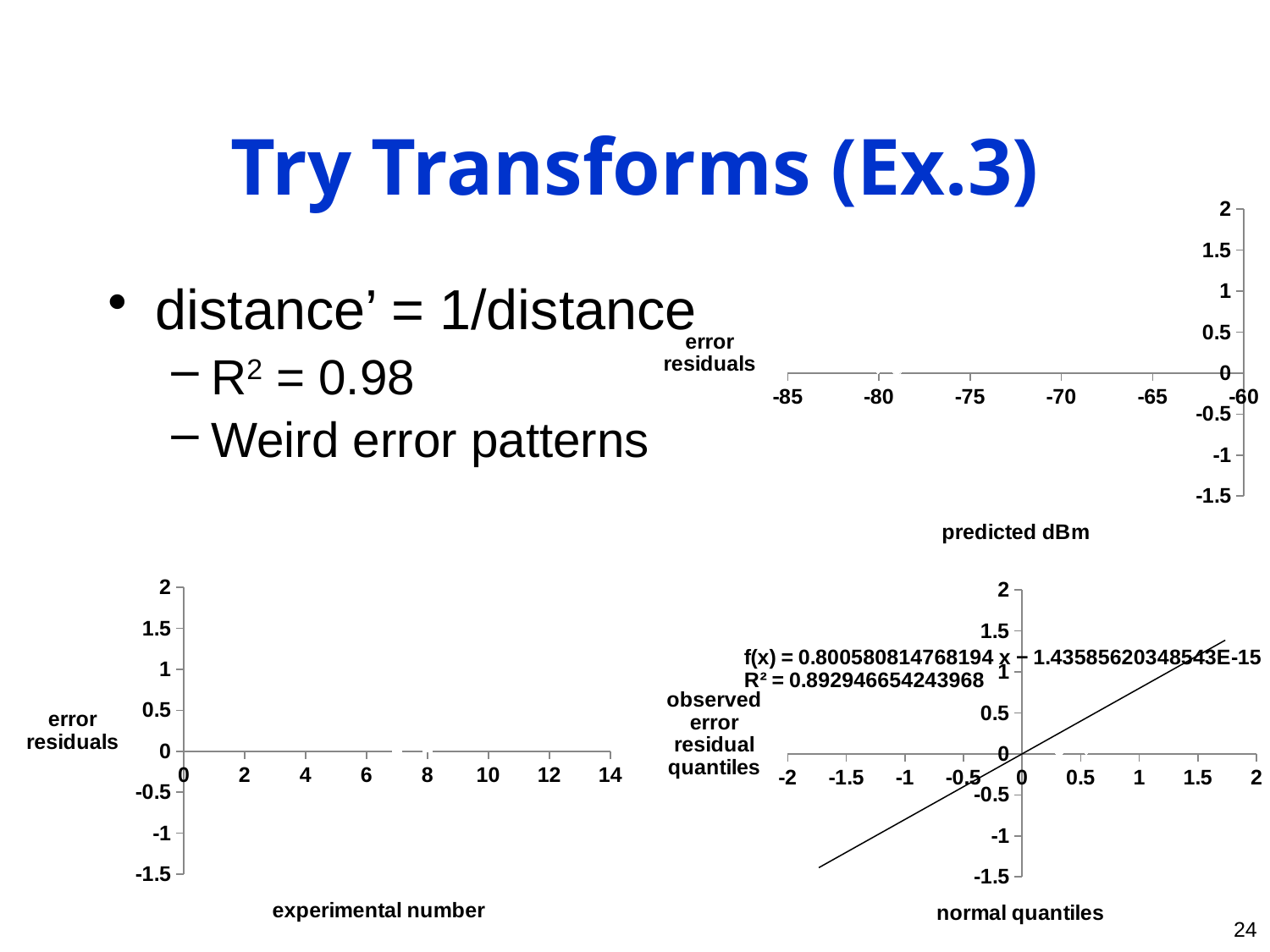
In the bottom-right chart (normal quantiles), what is the slope coefficient in the printed equation f(x)? 0.800580814768194 What is the x-axis label of the top-right chart? predicted dBm What is the x-axis label of the bottom-left chart? experimental number In the bottom-left chart (experimental number), what is the highest x-axis tick value shown? 14 In the bottom-right chart (normal quantiles), what is the lowest y-axis tick value shown? -1.5 In the top-right chart (predicted dBm), what is the lowest x-axis tick value shown? -85 In the bottom-right chart (normal quantiles), does the fitted line rise or fall as normal quantiles increase? rise In the bottom-right chart (normal quantiles), what R² value is printed next to the fitted line? 0.892946654243968 In the bottom-right chart (normal quantiles), what is the highest y-axis tick value shown? 2 How many charts are shown on the slide? 3